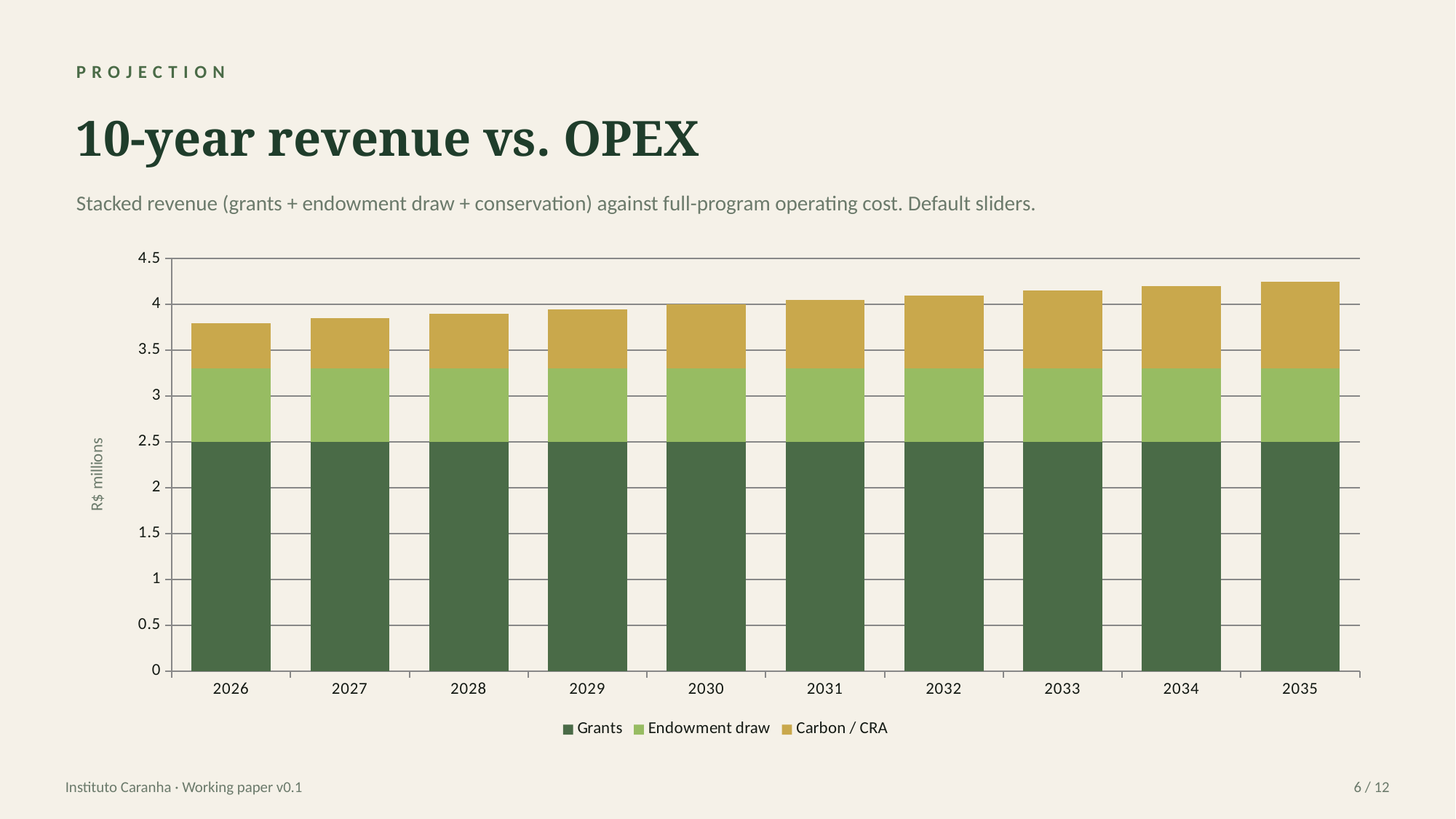
How many years are plotted along the x axis? 10 Which year has the lowest total stacked bar? 2026 How many series does the legend list? 3 What is the value of the Grants segment in 2026, in R$ millions? 2.5 Which series is shown in the top (gold) segment of each bar? Carbon / CRA Is the total stacked value for 2035 greater or less than 4? greater Which year has the highest total stacked bar? 2035 What is the label on the y axis? R$ millions What kind of chart is shown on the slide? Stacked bar chart Is the total stacked value for 2026 greater or less than 4? less Which year has the larger total stacked bar, 2027 or 2034? 2034 Does the total stacked revenue rise or fall from 2026 to 2035? rise